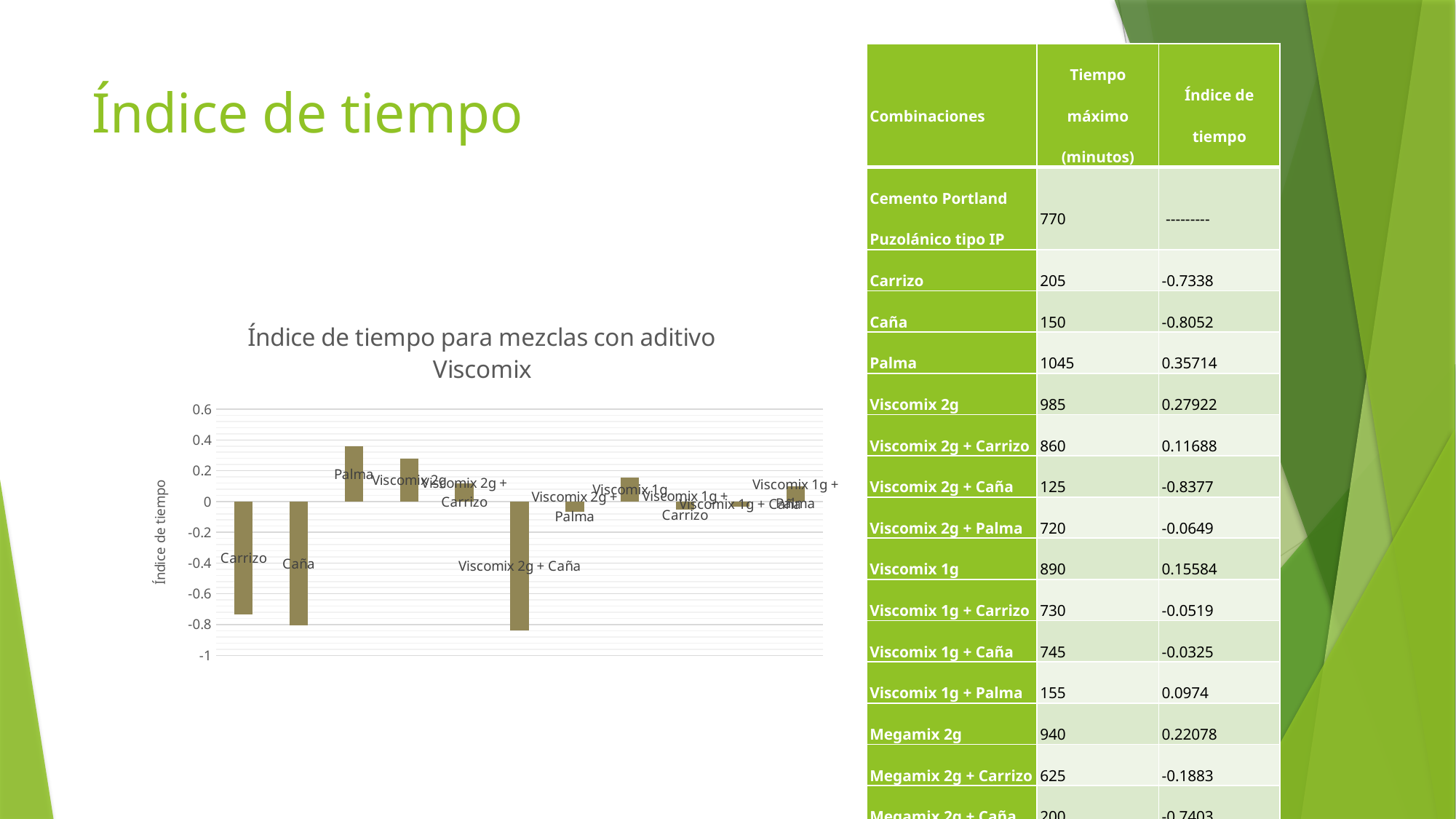
What is the title of the chart? Índice de tiempo para mezclas con aditivo Viscomix Which is larger, the value for Palma or the value for Viscomix 2g? Palma Is the value for Viscomix 2g + Carrizo greater or less than 0.2? less Which category has the highest value in the chart? Palma How many bars (categories) are plotted in the chart? 11 Which is larger, the value for Viscomix 2g or the value for Viscomix 1g? Viscomix 2g What is the label on the vertical axis of the chart? Índice de tiempo Is the value for Viscomix 2g + Caña greater or less than -0.6? less Is the value for Palma greater or less than 0.2? greater What kind of chart is shown on the slide? bar chart